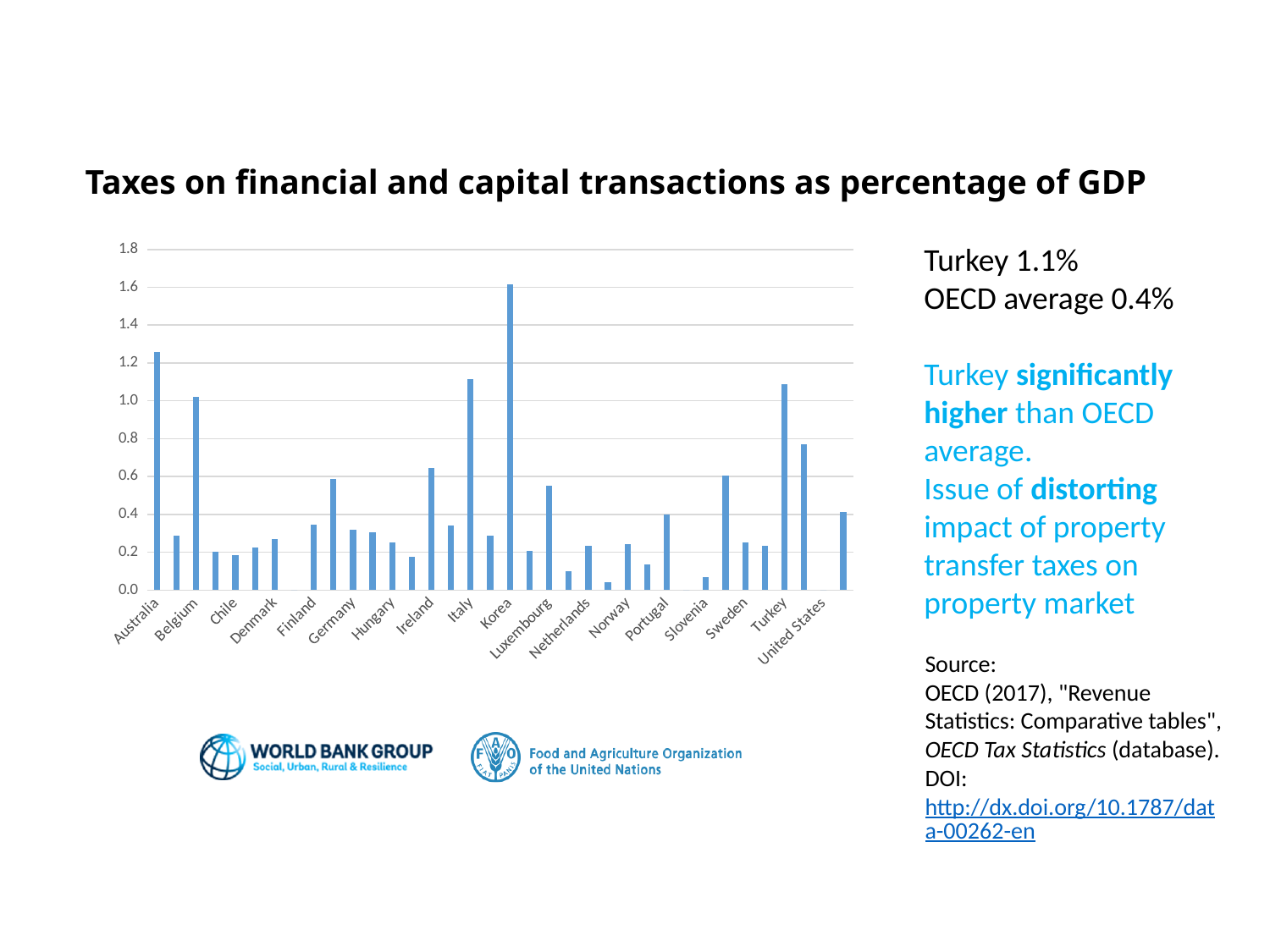
Which is larger, the value for Korea or the value for Australia? Korea According to the text beside the chart, what is the OECD average? 0.4% Which is larger, the value for Turkey or the value for Sweden? Turkey Which labelled country has the highest bar in the chart? Korea Is the value for Turkey greater or less than 0.8? greater Is the value for Slovenia greater or less than 0.2? less According to the text beside the chart, what is Turkey's value? 1.1% Is the value for Netherlands greater or less than 0.4? less What kind of chart is shown on the slide? bar chart What is the title of the chart? Taxes on financial and capital transactions as percentage of GDP